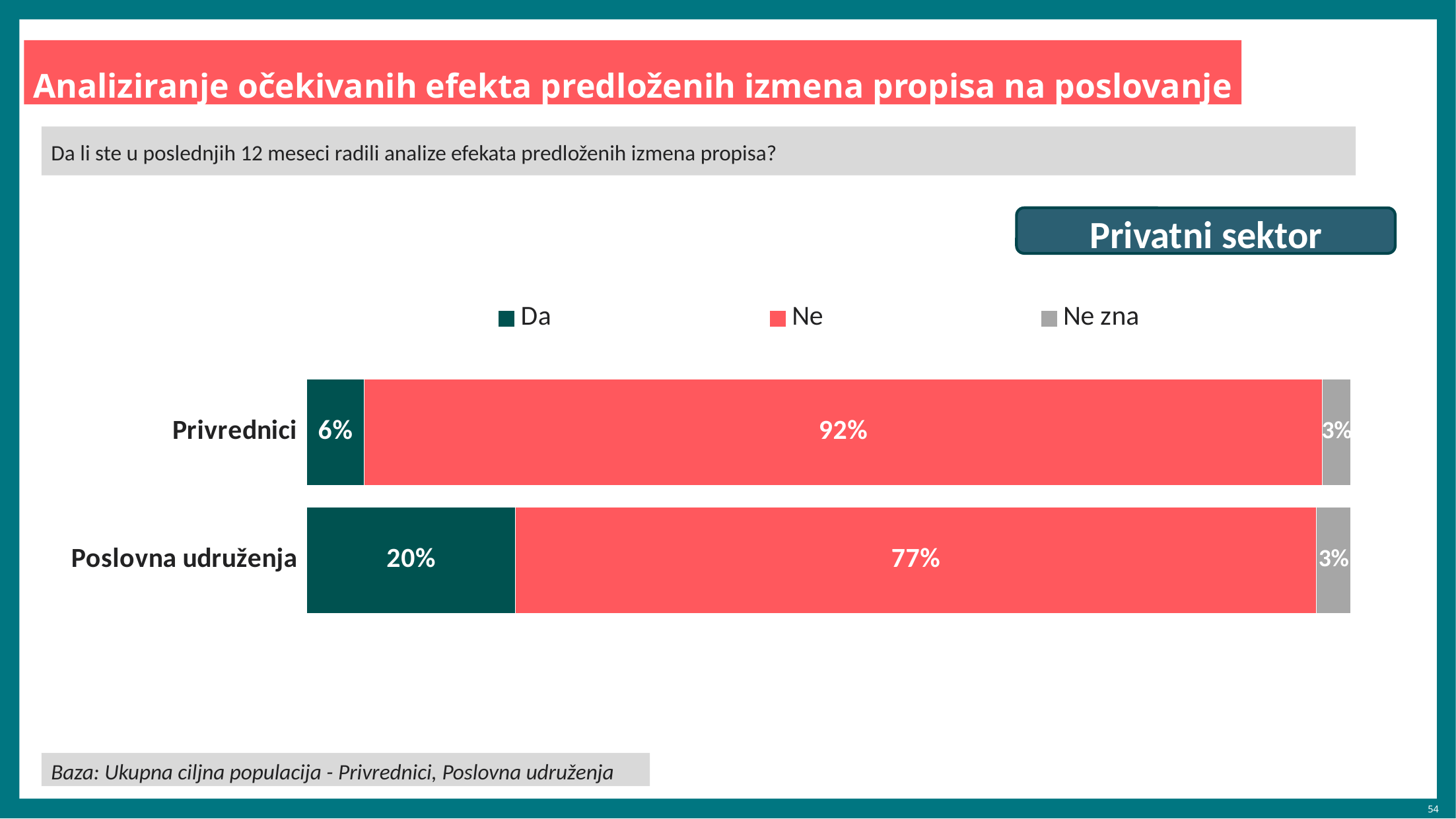
What percentage of Poslovna udruženja answered "Ne zna"? 3% Which category has the highest "Ne" share? Privrednici Which category has the higher "Da" share, Privrednici or Poslovna udruženja? Poslovna udruženja How many categories are shown on the chart? 2 What is the difference between the "Ne" shares of Privrednici and Poslovna udruženja? 15 percentage points What are the three legend entries of the chart? Da, Ne, Ne zna What kind of chart is shown on the slide? Stacked bar chart What percentage of Privrednici answered "Da"? 6% What percentage of Poslovna udruženja answered "Ne"? 77% What is the difference between the "Da" shares of Poslovna udruženja and Privrednici? 14 percentage points What percentage of Privrednici answered "Ne"? 92% How many series does the legend list? 3